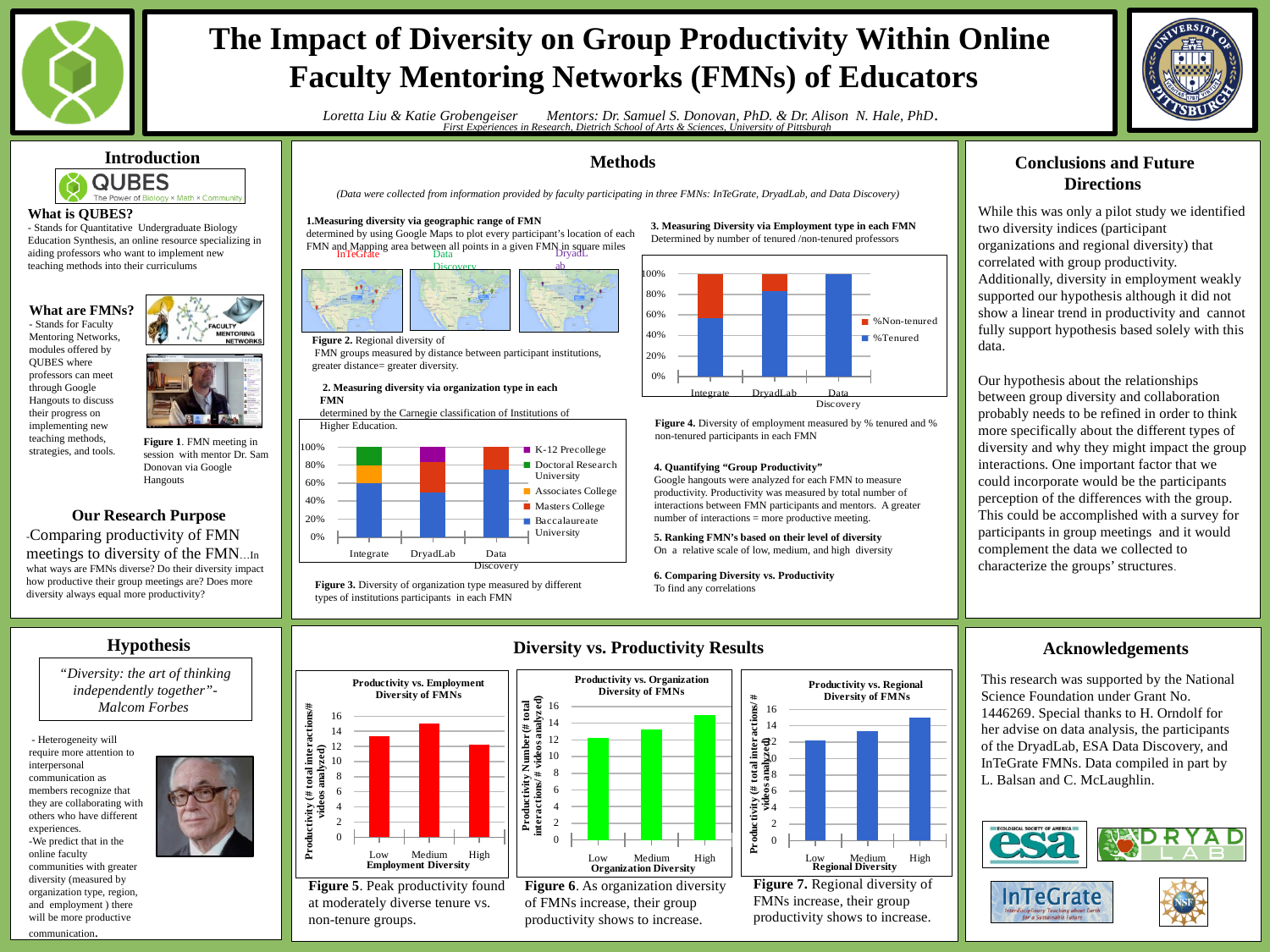
How many series does the legend of the Figure 3 organization type chart list? 5 What kind of chart is the 'Productivity vs. Regional Diversity of FMNs' chart? bar chart In the 'Productivity vs. Organization Diversity of FMNs' chart, do the values rise or fall from Low to High organization diversity? rise In the 'Productivity vs. Employment Diversity of FMNs' chart, which employment diversity level has the highest productivity? Medium In the 'Productivity vs. Employment Diversity of FMNs' chart, is the value for High employment diversity greater or less than 14? less How many series does the legend of the Figure 4 employment diversity chart list? 2 In the 'Productivity vs. Employment Diversity of FMNs' chart, which employment diversity level has the lowest productivity? High In the 'Productivity vs. Regional Diversity of FMNs' chart, which regional diversity level has the highest productivity? High In the Figure 4 chart of employment diversity, is the %Tenured value for Integrate greater or less than 80%? less In the Figure 4 chart of employment diversity, which FMN has the highest %Tenured share? Data Discovery In the 'Productivity vs. Regional Diversity of FMNs' chart, is the value for Low regional diversity greater or less than 10? greater